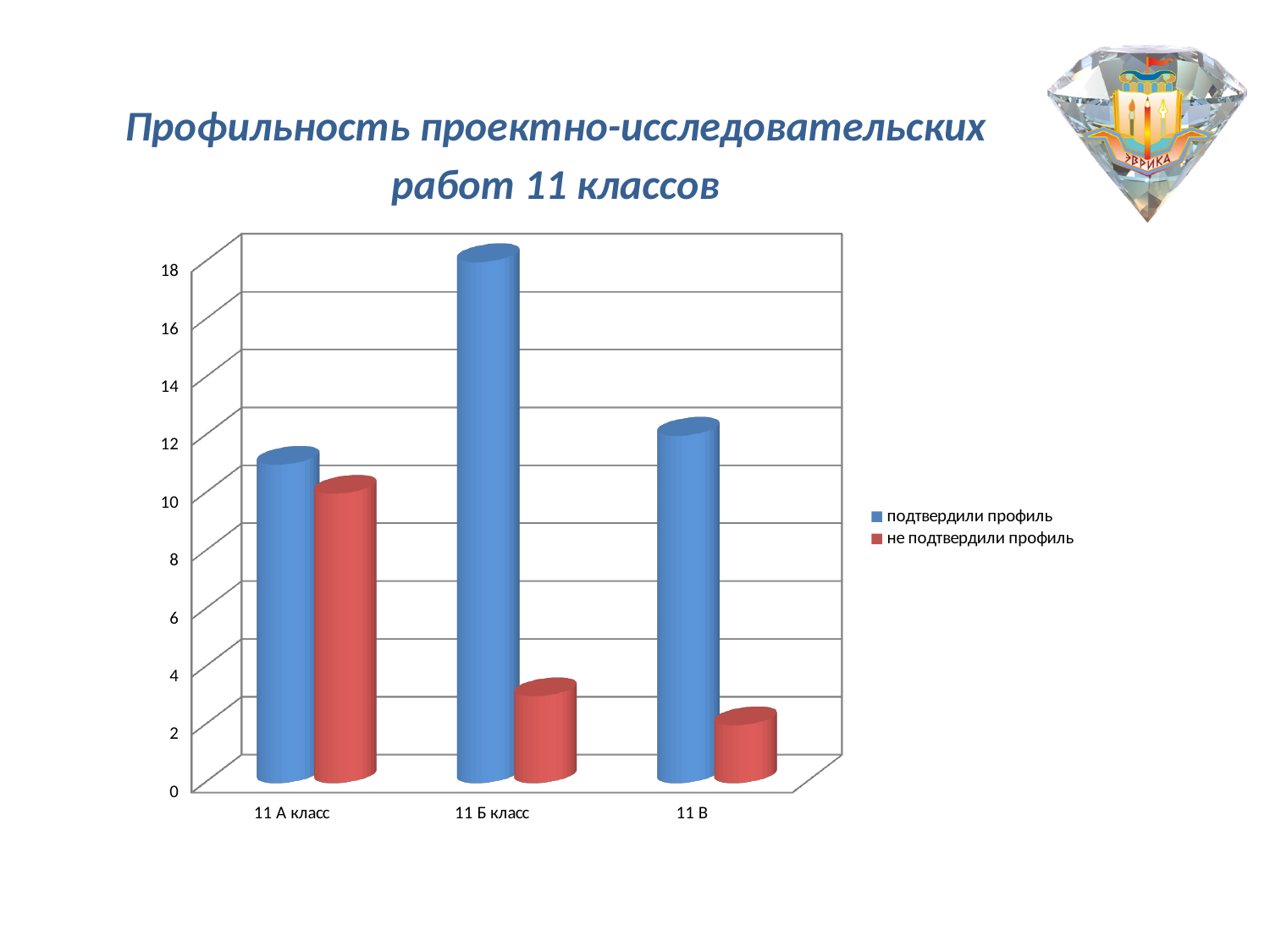
Which is larger: подтвердили профиль for 11 Б класс or for 11 В? 11 Б класс How many series does the legend list? 2 How many classes (categories) are shown on the x axis? 3 What kind of chart is shown on the slide? bar chart Which class has the highest value for подтвердили профиль? 11 Б класс Which class has the highest value for не подтвердили профиль? 11 А класс Is the value for не подтвердили профиль in 11 А класс greater or less than 8? greater Is the value for подтвердили профиль in 11 Б класс greater or less than 16? greater Which class has the lowest value for подтвердили профиль? 11 А класс Is the value for не подтвердили профиль in 11 Б класс greater or less than 4? less Which colour represents the series не подтвердили профиль? red